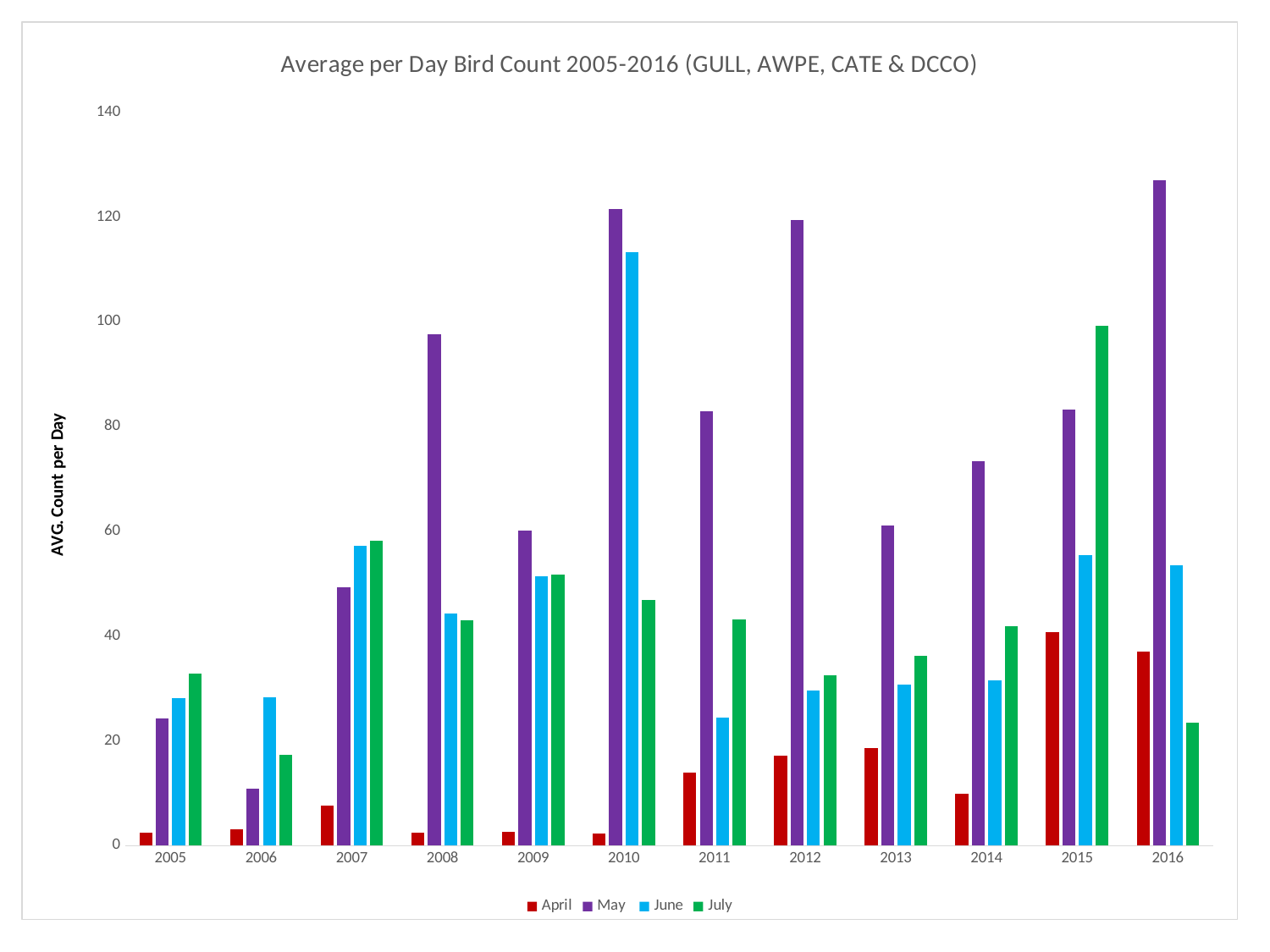
Which is larger, the June value for 2010 or the June value for 2016? 2010 In which year is the May value the highest? 2016 Is the April value for 2015 greater or less than 20? greater In which year is the July value the lowest? 2006 Is the July value for 2015 greater or less than 80? greater How many series does the legend list? 4 How many years are shown along the x axis? 12 What kind of chart is shown on the slide? bar chart Is the May value for 2010 greater or less than 100? greater What is the title of the chart? Average per Day Bird Count 2005-2016 (GULL, AWPE, CATE & DCCO) In 2015, which is larger, the May value or the July value? July What is the label on the vertical axis? AVG. Count per Day